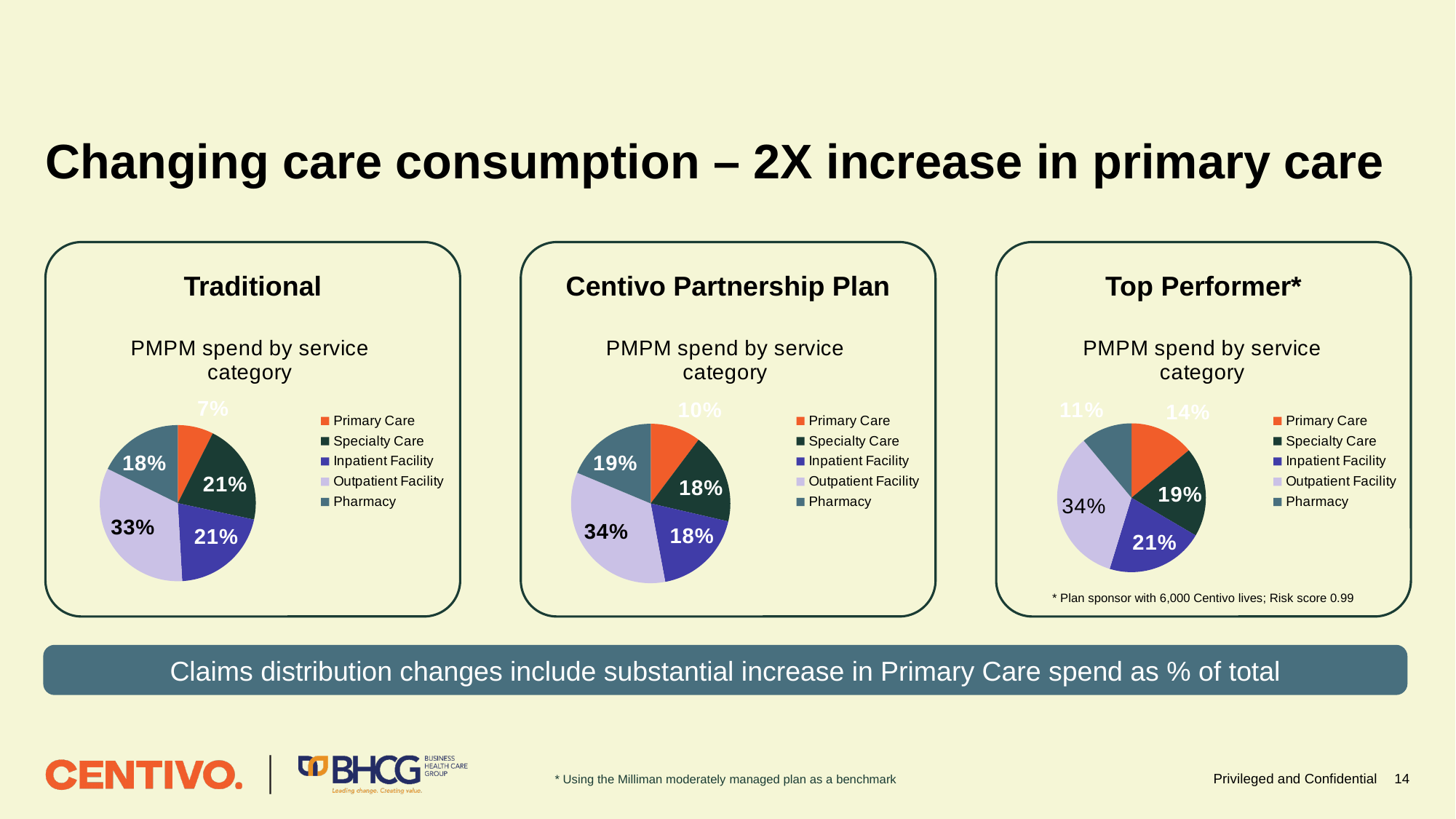
In the Traditional chart, what is the value for Outpatient Facility? 33% In the Centivo Partnership Plan chart, which service category has the largest share? Outpatient Facility How many service categories does the legend of the Traditional chart list? 5 In the Top Performer* chart, which is larger, Inpatient Facility or Specialty Care? Inpatient Facility In the Top Performer* chart, which category has the smallest share? Pharmacy In the Traditional chart, what share of PMPM spend is Primary Care? 7% In the Centivo Partnership Plan chart, what share of PMPM spend is Primary Care? 10% In the Top Performer* chart, what is the value for Pharmacy? 11% In the Traditional chart, which service category has the smallest share? Primary Care What type of chart is used in the Centivo Partnership Plan panel? Pie chart In the Top Performer* chart, what share of PMPM spend is Primary Care? 14% In the Centivo Partnership Plan chart, what is the difference between Outpatient Facility and Pharmacy? 15%